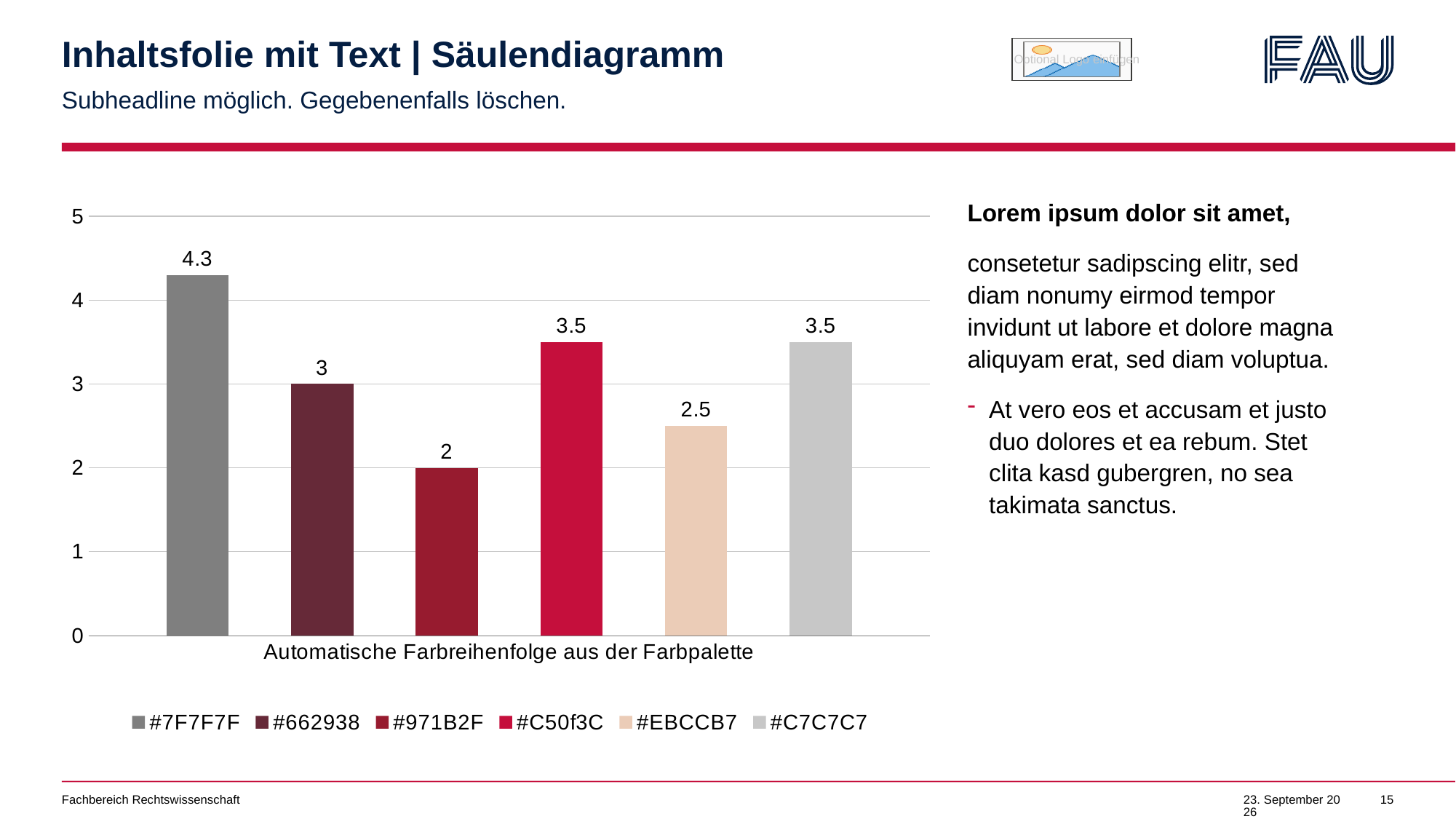
What is the difference between the values of #7F7F7F and #662938? 1.3 Which is larger, the value for #662938 or the value for #EBCCB7? #662938 What is the category label shown below the bars? Automatische Farbreihenfolge aus der Farbpalette How many series does the legend list? 6 What is the value of the #C7C7C7 series? 3.5 Which series has the highest value? #7F7F7F What kind of chart is shown on the slide? bar chart What is the value of the #EBCCB7 series? 2.5 Which series has the lowest value? #971B2F Is the value for #C50f3C greater or less than 3? greater What is the value of the #971B2F series? 2 What is the value of the #7F7F7F series? 4.3